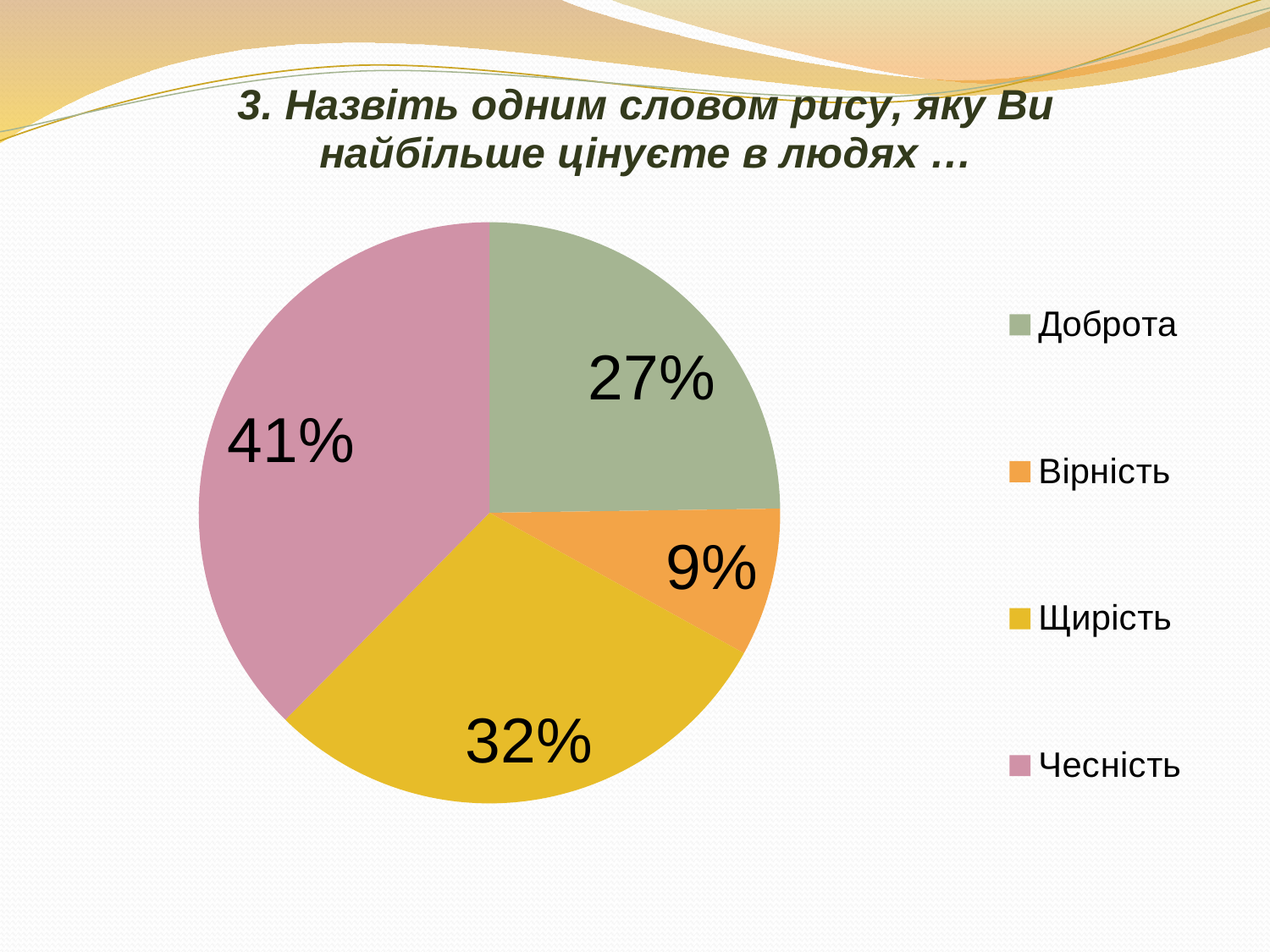
How many slices does the pie chart have? 4 What percentage is shown for Вірність? 9% Which category has the smallest slice of the pie? Вірність How many entries does the legend list? 4 What kind of chart is shown on the slide? pie chart Which is larger, the slice for Щирість or the slice for Доброта? Щирість What colour is the slice for Щирість? yellow Which category has the largest slice of the pie? Чесність What percentage is shown for Чесність? 41% What percentage is shown for Щирість? 32% What is the difference between the percentages for Чесність and Доброта? 14% What percentage is shown for Доброта? 27%